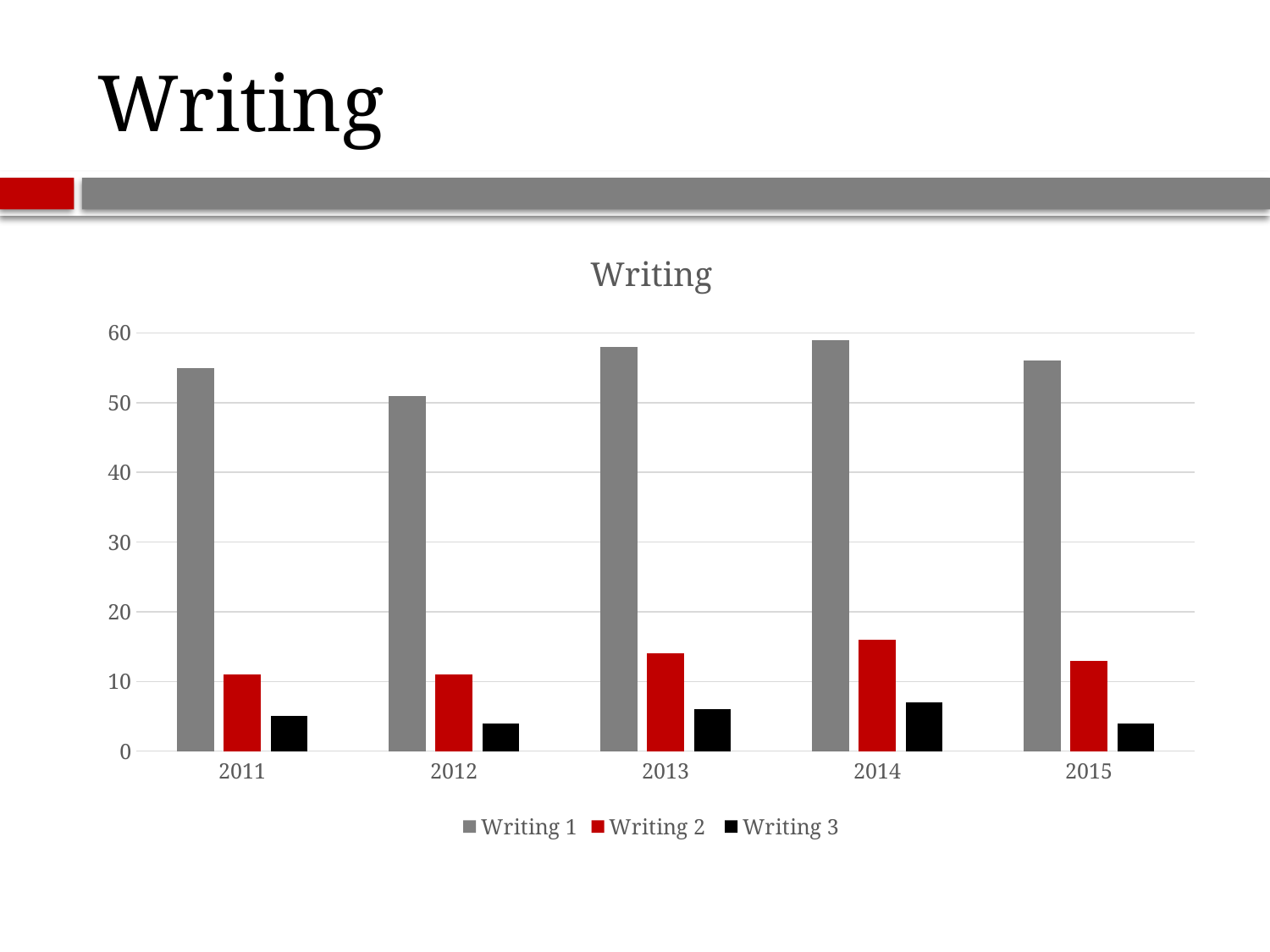
What is the title of the chart? Writing How many years are shown on the x axis? 5 Which is larger, the Writing 1 value for 2011 or for 2012? 2011 How many series does the legend list? 3 In which year is the Writing 1 value lowest? 2012 What kind of chart is shown on the slide? bar chart Is the Writing 1 value for 2011 greater or less than 50? greater Is the Writing 2 value for 2014 greater or less than 20? less Does the Writing 2 value rise or fall from 2012 to 2014? rise Which series is shown in red? Writing 2 Is the Writing 3 value for 2013 greater or less than 10? less In which year is the Writing 2 value highest? 2014